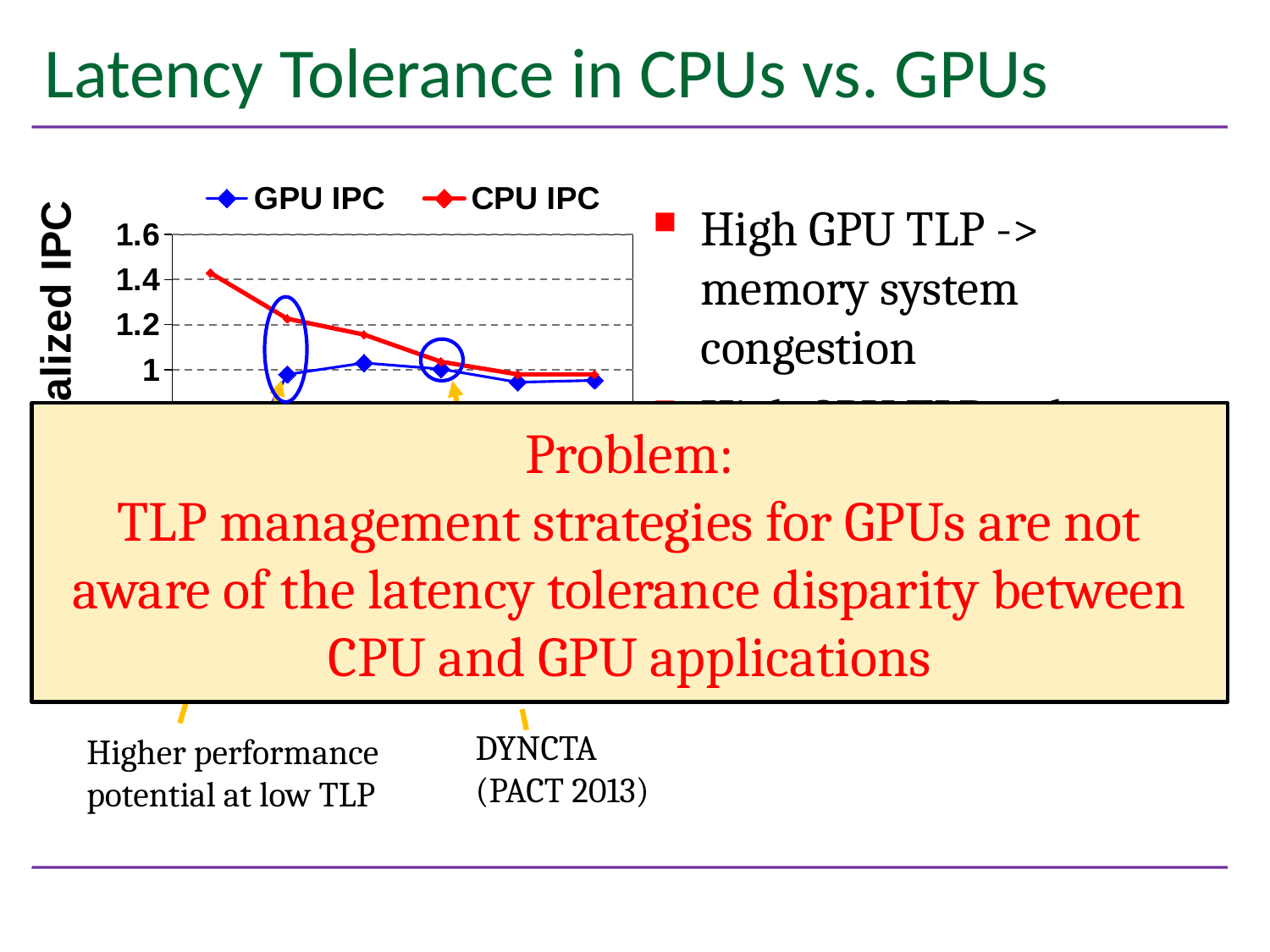
Is the highest value of the GPU IPC series greater or less than 1.2? less Which colour is used for the CPU IPC series? red Which series reaches the highest value on the chart? CPU IPC What kind of chart is shown on the slide? line chart Is the leftmost CPU IPC value greater or less than 1? greater How many series does the chart legend list? 2 At the second x-axis position (where the first blue marker appears), which series has the larger value, GPU IPC or CPU IPC? CPU IPC What are the two series named in the chart legend? GPU IPC and CPU IPC At the leftmost point of the CPU IPC series, is the value greater or less than 1.2? greater Does the CPU IPC series rise or fall along the x axis? fall